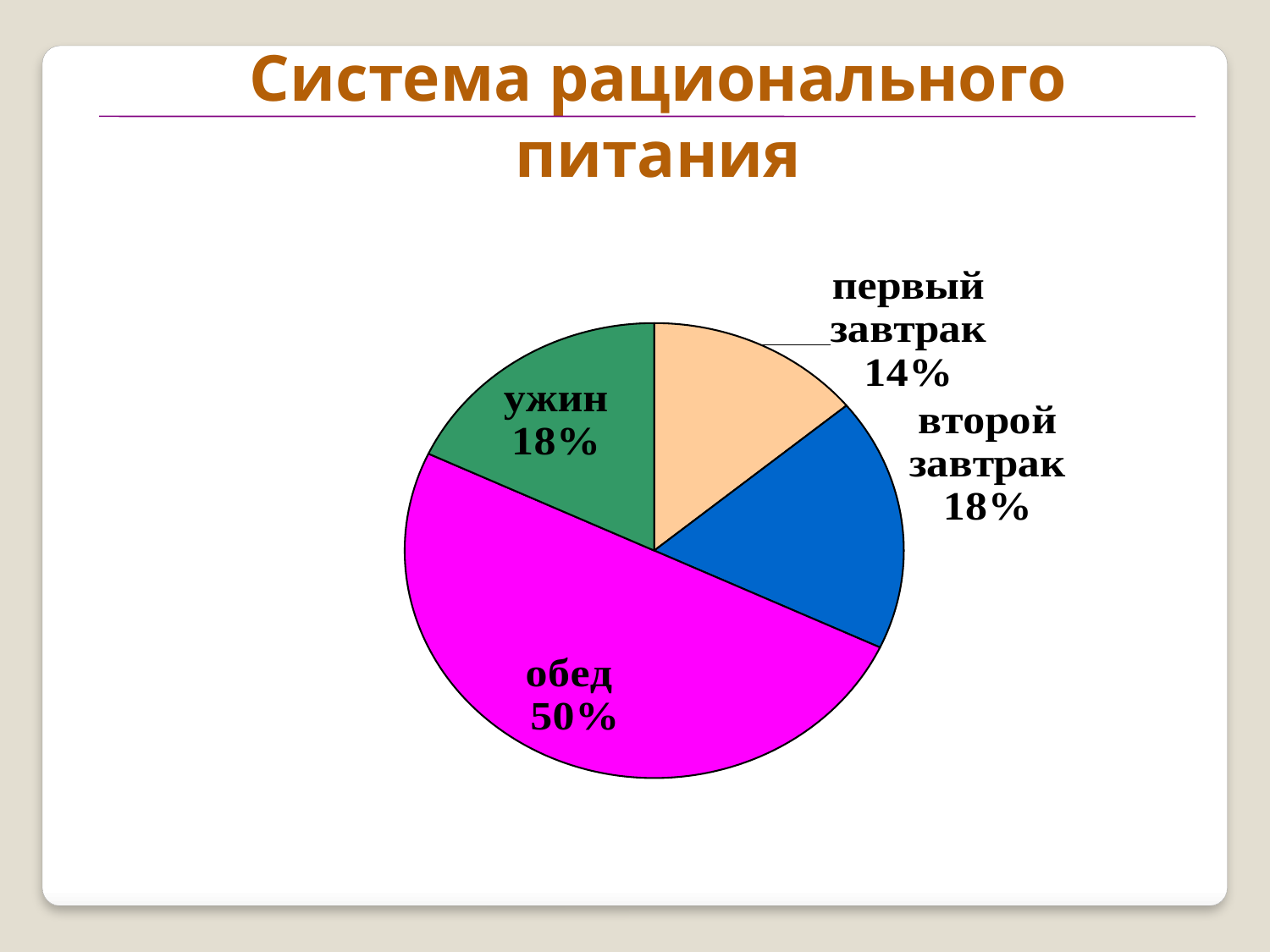
What is the value shown for ужин (dinner)? 18% Which category has the largest slice of the pie? обед What colour is the slice for обед? magenta Which is larger, the share for обед or the share for второй завтрак? обед What is the value shown for второй завтрак (second breakfast)? 18% What is the value shown for первый завтрак (first breakfast)? 14% How many slices does the pie chart have? 4 What kind of chart is shown on the slide? pie chart Which category has the smallest slice of the pie? первый завтрак What is the difference between the shares of второй завтрак and первый завтрак? 4% What is the difference between the shares of обед and ужин? 32% What share of the pie does обед (lunch) take? 50%